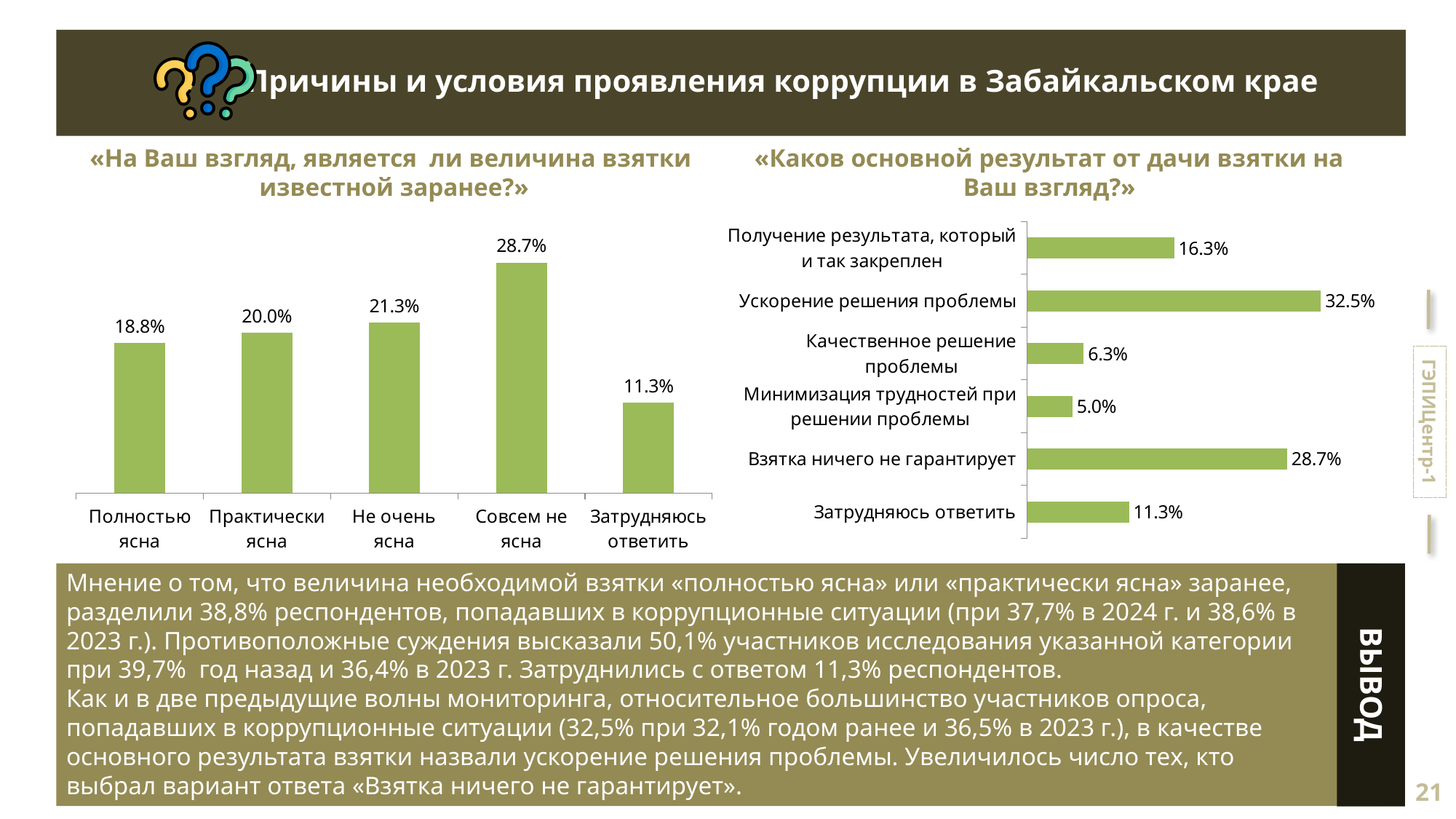
On the left chart («На Ваш взгляд, является ли величина взятки известной заранее?»), what is the difference between «Совсем не ясна» and «Практически ясна»? 8.7% On the left chart («На Ваш взгляд, является ли величина взятки известной заранее?»), what is the value for «Полностью ясна»? 18.8% On the right chart («Каков основной результат от дачи взятки на Ваш взгляд?»), which category has the highest value? Ускорение решения проблемы On the left chart («На Ваш взгляд, является ли величина взятки известной заранее?»), what is the value for «Совсем не ясна»? 28.7% On the right chart («Каков основной результат от дачи взятки на Ваш взгляд?»), what is the difference between «Ускорение решения проблемы» and «Качественное решение проблемы»? 26.2% On the right chart («Каков основной результат от дачи взятки на Ваш взгляд?»), how many categories are shown? 6 On the right chart («Каков основной результат от дачи взятки на Ваш взгляд?»), what is the value for «Минимизация трудностей при решении проблемы»? 5.0% On the left chart («На Ваш взгляд, является ли величина взятки известной заранее?»), what type of chart is it? Bar chart On the left chart («На Ваш взгляд, является ли величина взятки известной заранее?»), which category has the lowest value? Затрудняюсь ответить On the left chart («На Ваш взгляд, является ли величина взятки известной заранее?»), how many categories are shown? 5 On the right chart («Каков основной результат от дачи взятки на Ваш взгляд?»), what is the value for «Ускорение решения проблемы»? 32.5% On the right chart («Каков основной результат от дачи взятки на Ваш взгляд?»), which is larger: «Взятка ничего не гарантирует» or «Получение результата, который и так закреплен»? Взятка ничего не гарантирует